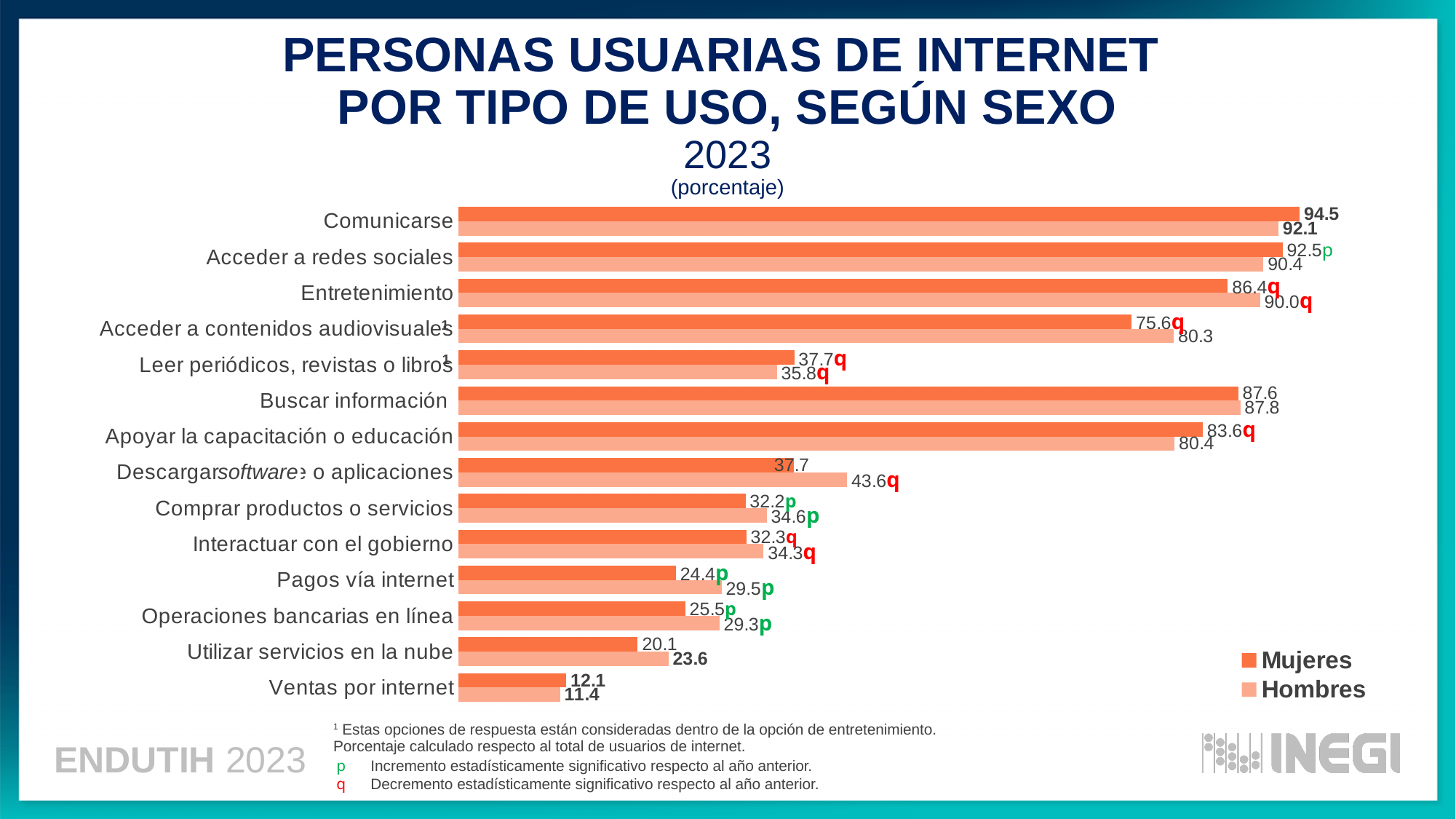
What is the value for Mujeres for Pagos vía internet? 24.4 What is the value for Hombres for Descargar software o aplicaciones? 43.6 Which series is shown in the lighter orange colour in the legend? Hombres What is the difference between the Hombres and Mujeres values for Entretenimiento? 3.6 What kind of chart is shown on the slide? bar chart For Apoyar la capacitación o educación, which is larger, the Mujeres value or the Hombres value? Mujeres How many categories (types of use) are shown in the chart? 14 Which category has the lowest value for Hombres? Ventas por internet What is the value for Mujeres for Comunicarse? 94.5 Which category has the highest value for Mujeres? Comunicarse What is the difference between the Mujeres and Hombres values for Utilizar servicios en la nube? 3.5 How many series does the legend list? 2